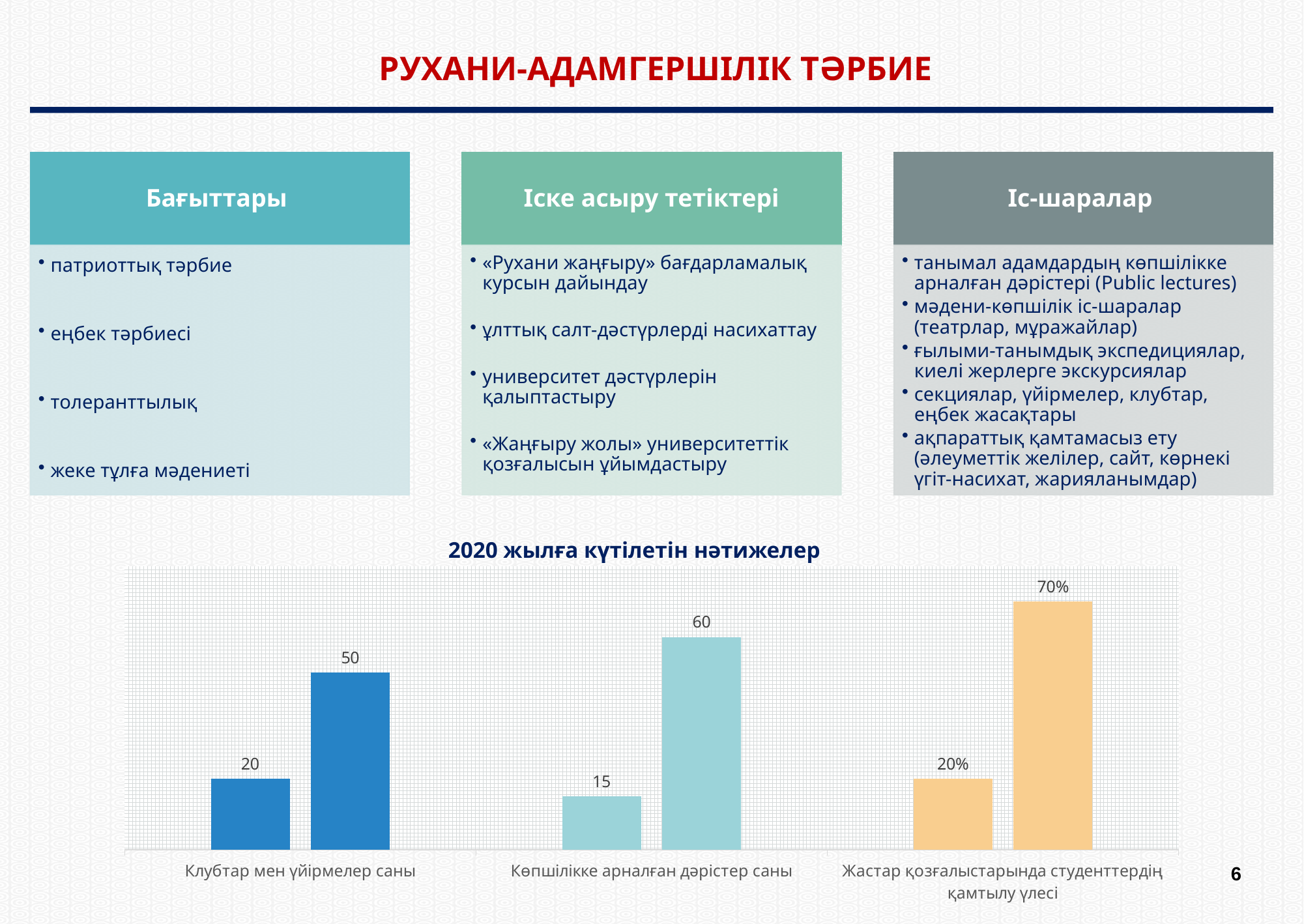
How many categories are shown on the x axis of the chart? 3 What is the value of the second (right) bar for "Клубтар мен үйірмелер саны"? 50 Which is larger: the first bar for "Клубтар мен үйірмелер саны" or the first bar for "Көпшілікке арналған дәрістер саны"? Клубтар мен үйірмелер саны What is the difference between the two bars for "Көпшілікке арналған дәрістер саны"? 45 What is the difference between the two bars for "Клубтар мен үйірмелер саны"? 30 What is the value of the first (left) bar for "Клубтар мен үйірмелер саны"? 20 What is the value of the second (right) bar for "Көпшілікке арналған дәрістер саны"? 60 What kind of chart is shown under the title "2020 жылға күтілетін нәтижелер"? bar chart What is the title of the chart on the slide? 2020 жылға күтілетін нәтижелер What is the value of the first (left) bar for "Көпшілікке арналған дәрістер саны"? 15 Which category has the lowest value among the first (left) bars? Көпшілікке арналған дәрістер саны What is the value of the second (right) bar for "Жастар қозғалыстарында студенттердің қамтылу үлесі"? 70%